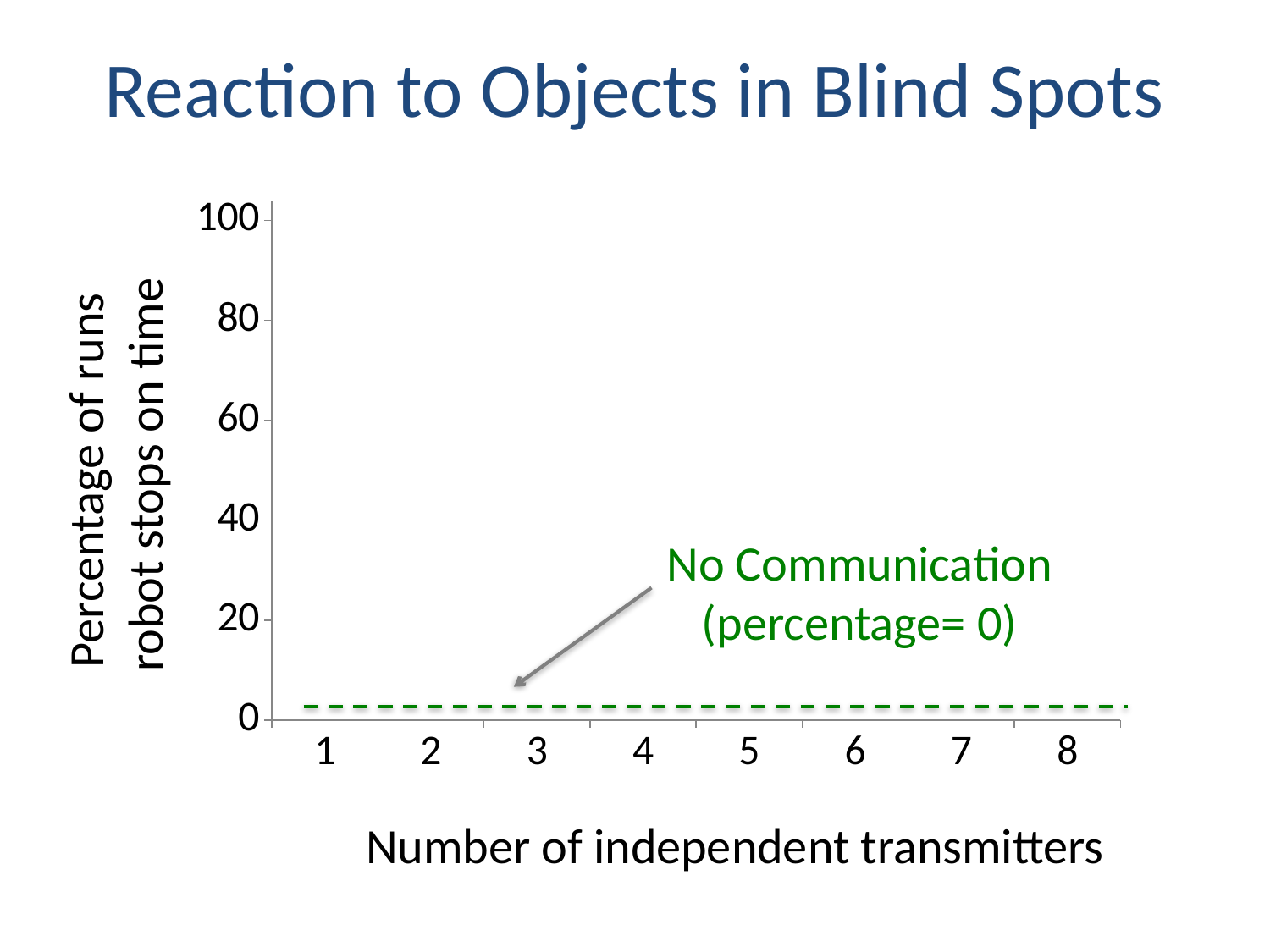
What kind of chart is shown on the slide? line chart Is the value of the No Communication line at 4 transmitters greater or less than 20? less What is the label of the x axis? Number of independent transmitters What percentage is given for the No Communication line? 0 How many values for the number of independent transmitters are shown on the x axis? 8 Does the No Communication line rise, fall, or stay flat as the number of independent transmitters increases? stays flat What is the highest value shown on the y axis? 100 What is the title of the chart? Reaction to Objects in Blind Spots Is the value of the No Communication line at 8 transmitters greater or less than 40? less